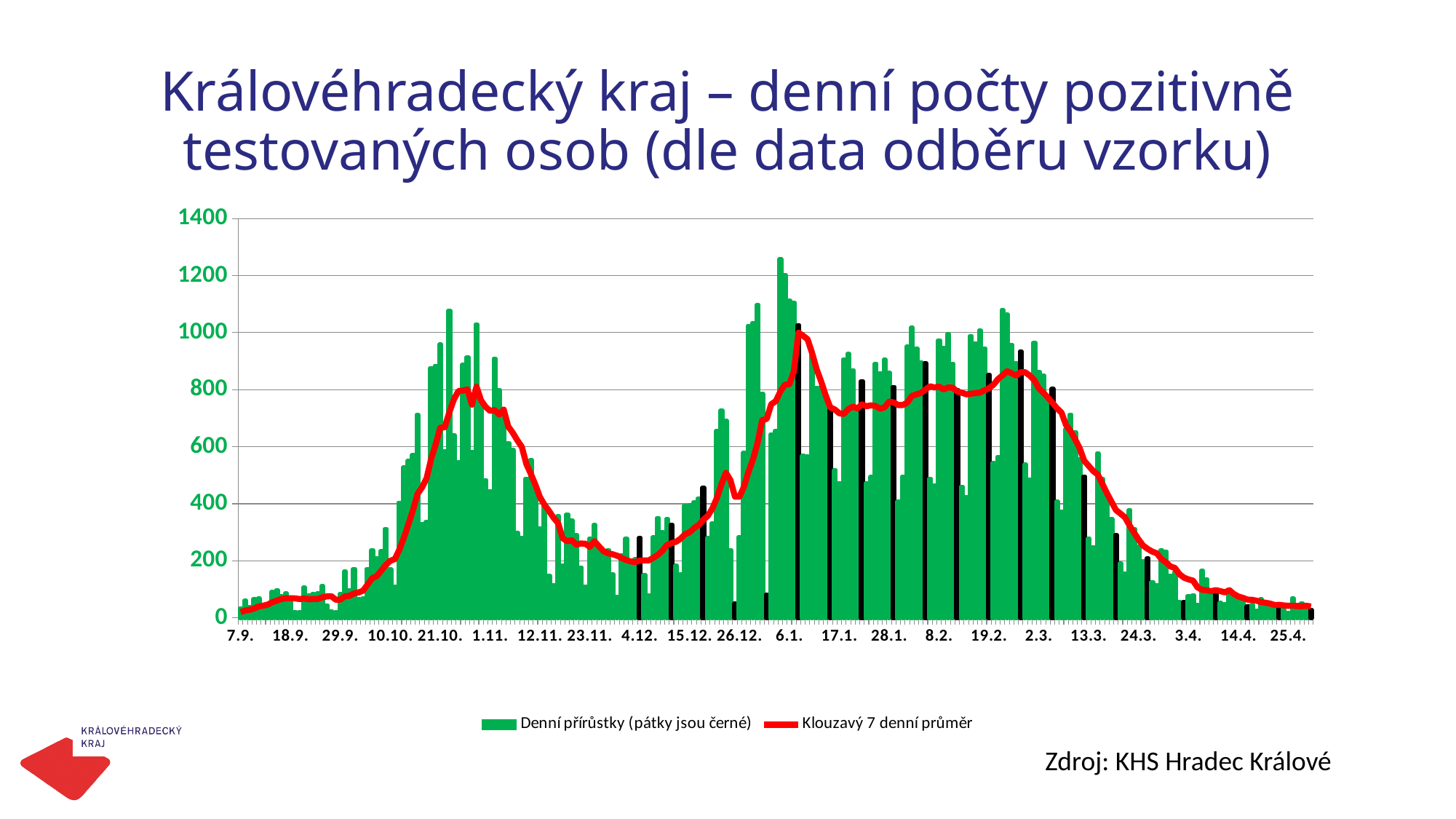
According to the legend, which days are drawn as black bars? Fridays (pátky) How many date labels are shown on the horizontal axis? 22 Is the 7-day moving average higher at 6.1. or at 1.11.? 6.1. What is the highest value shown on the vertical axis? 1400 Is the daily count bar at 6.1. greater or less than 1000? greater Does the 7-day moving average rise or fall between 2.3. and 3.4.? fall Is the daily count bar at 25.4. greater or less than 200? less Around which labeled date does the 7-day moving average reach its highest point? 6.1. Is the daily count bar at 7.9. greater or less than 200? less What kind of chart is shown on the slide? A bar chart with a line How many series does the legend list? 2 What does the red line in the chart represent, according to the legend? Klouzavý 7 denní průměr